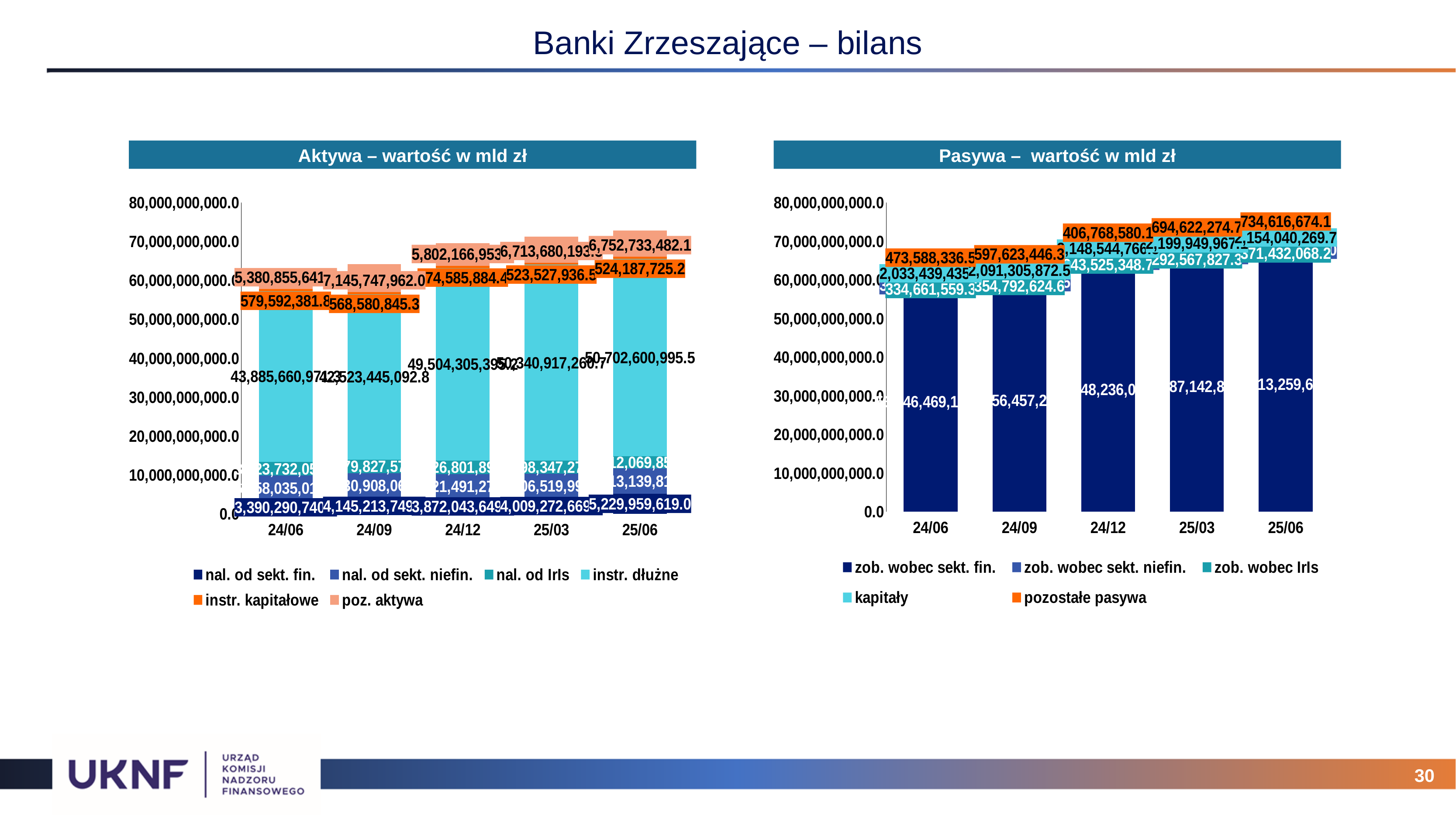
What kind of chart is the 'Aktywa – wartość w mld zł' chart? stacked bar chart In the 'Pasywa – wartość w mld zł' chart, what is the value of 'pozostałe pasywa' for 24/12? 406,768,580.1 In the 'Pasywa – wartość w mld zł' chart, what is the value of 'pozostałe pasywa' for 25/06? 734,616,674.1 In the 'Pasywa – wartość w mld zł' chart, is the value of 'zob. wobec sekt. fin.' for 25/06 greater or less than 50,000,000,000.0? greater In the 'Aktywa – wartość w mld zł' chart, what is the value of 'nal. od sekt. fin.' for 25/06? 5,229,959,619.0 How many series does the legend of the 'Aktywa – wartość w mld zł' chart list? 6 In the 'Aktywa – wartość w mld zł' chart, what is the value of 'poz. aktywa' for 25/06? 6,752,733,482.1 In the 'Aktywa – wartość w mld zł' chart, what is the value of 'instr. kapitałowe' for 25/06? 524,187,725.2 How many periods are shown on the x axis of the 'Pasywa – wartość w mld zł' chart? 5 In the 'Pasywa – wartość w mld zł' chart, what is the difference between 'pozostałe pasywa' for 25/06 and for 25/03? 39,994,399.4 In the 'Pasywa – wartość w mld zł' chart, in which period is 'pozostałe pasywa' lowest? 24/12 How many series does the legend of the 'Pasywa – wartość w mld zł' chart list? 5